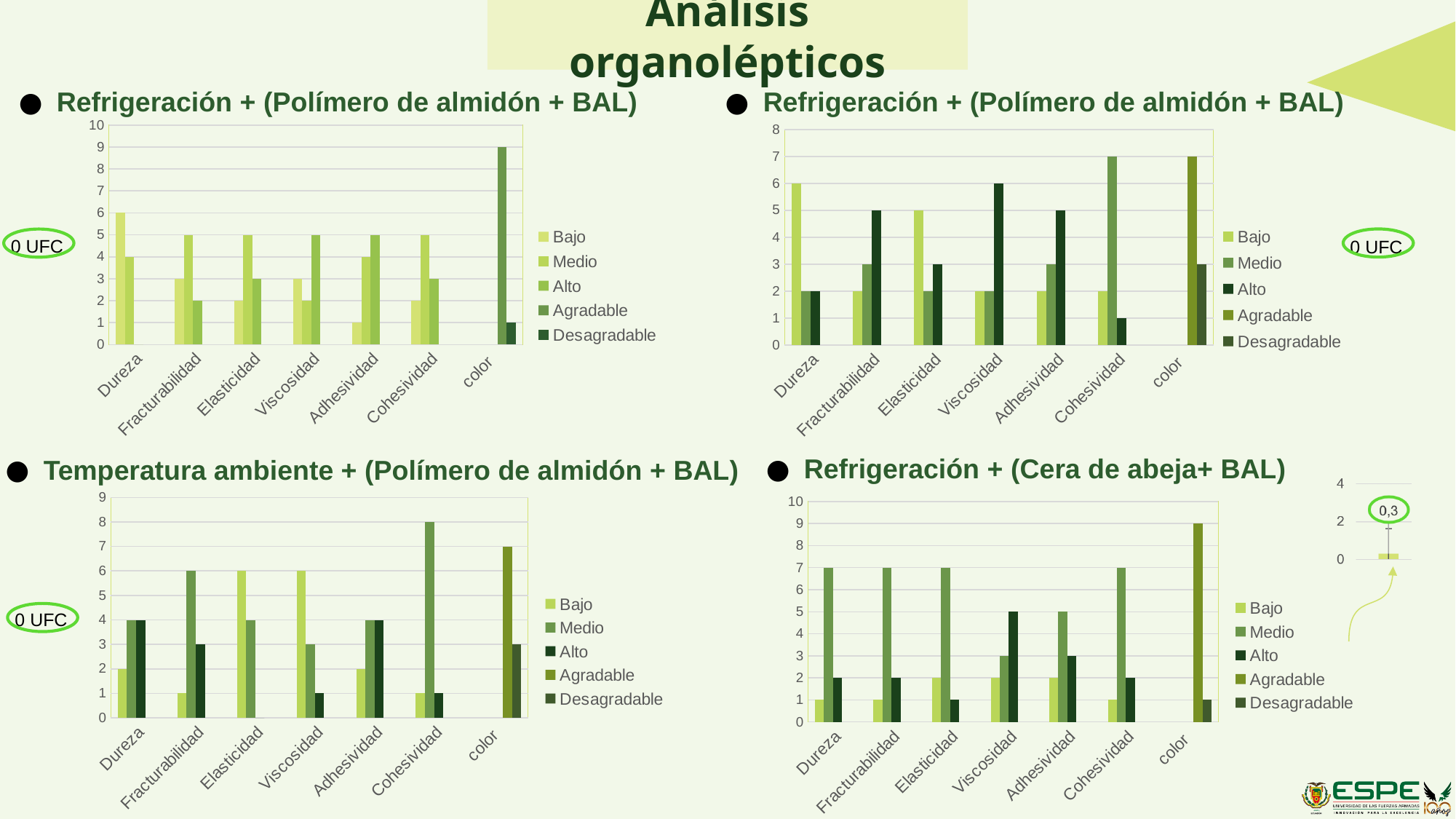
What kind of chart is the bottom-left chart titled 'Temperatura ambiente + (Polímero de almidón + BAL)'? bar chart How many series does the legend of the bottom-right chart 'Refrigeración + (Cera de abeja+ BAL)' list? 5 In the top-left chart, what value does the tallest bar in the 'color' category reach? 9 In the bottom-right chart 'Refrigeración + (Cera de abeja+ BAL)', which category contains the tallest bar? color What is the highest value shown on the y axis of the top-right chart? 8 In the top-left chart, is the 'Bajo' value for Dureza greater or less than 5? greater In the bottom-left chart 'Temperatura ambiente + (Polímero de almidón + BAL)', what value does the tallest bar reach? 8 In the top-left chart, which category contains the tallest bar? color In the bottom-left chart, for the 'color' category, which is larger: the 'Agradable' bar or the 'Desagradable' bar? Agradable In the bottom-left chart 'Temperatura ambiente + (Polímero de almidón + BAL)', which category contains the tallest bar? Cohesividad How many categories are shown on the x axis of the top-left chart? 7 In the bottom-left chart, what is the difference between the 'Agradable' bar (7) and the 'Desagradable' bar (3) for the 'color' category? 4